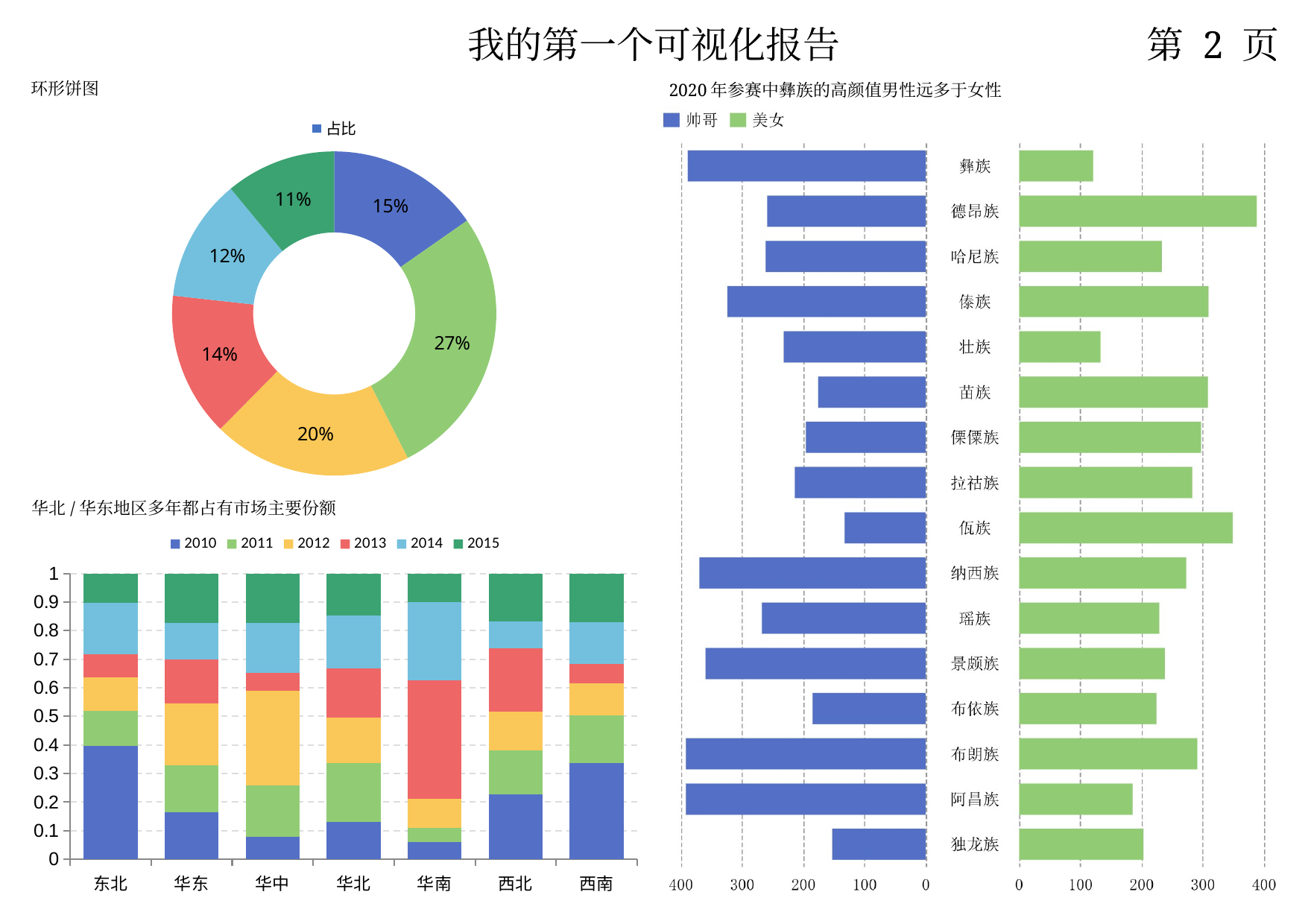
How many series does the legend of the chart titled 2020 年参赛中彝族的高颜值男性远多于女性 list? 2 How many series does the legend of the chart titled 华北 / 华东地区多年都占有市场主要份额 list? 6 In the chart titled 华北 / 华东地区多年都占有市场主要份额, is the 2010 value for 东北 greater or less than 0.3? greater In the donut chart titled 环形饼图, what is the largest slice's share? 27% In the chart titled 2020 年参赛中彝族的高颜值男性远多于女性, is the 美女 value for 彝族 greater or less than 200? less How many slices does the donut chart titled 环形饼图 have? 6 What kind of chart is the chart titled 华北 / 华东地区多年都占有市场主要份额? stacked bar chart How many categories are shown on the x axis of the chart titled 华北 / 华东地区多年都占有市场主要份额? 7 In the chart titled 2020 年参赛中彝族的高颜值男性远多于女性, which is larger for 德昂族, the 帅哥 value or the 美女 value? 美女 In the donut chart titled 环形饼图, what is the smallest slice's share? 11% In the chart titled 2020 年参赛中彝族的高颜值男性远多于女性, which ethnic group has the highest 美女 value? 德昂族 In the donut chart titled 环形饼图, what is the difference between the largest slice (27%) and the smallest slice (11%)? 16%